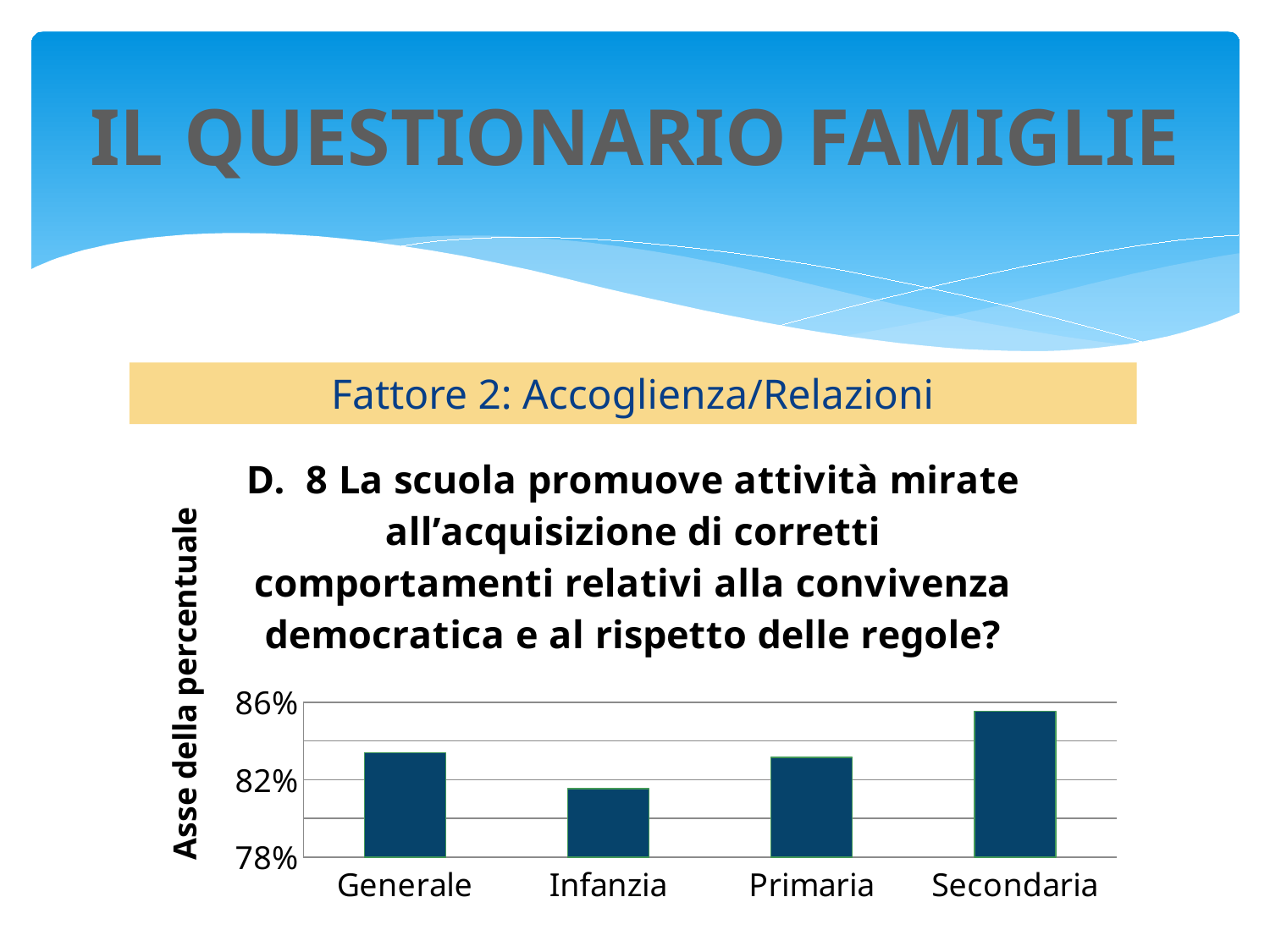
Which is larger, the value for Secondaria or the value for Infanzia? Secondaria What is the label of the vertical axis of the chart? Asse della percentuale Is the value for Primaria greater or less than 82%? greater Which category has the lowest bar in the chart? Infanzia Is the value for Generale greater or less than 82%? greater Is the value for Infanzia greater or less than 82%? less What is the lowest value shown on the vertical axis of the chart? 78% How many categories are shown on the x axis of the chart? 4 What kind of chart is shown on the slide? bar chart Which category has the highest bar in the chart? Secondaria